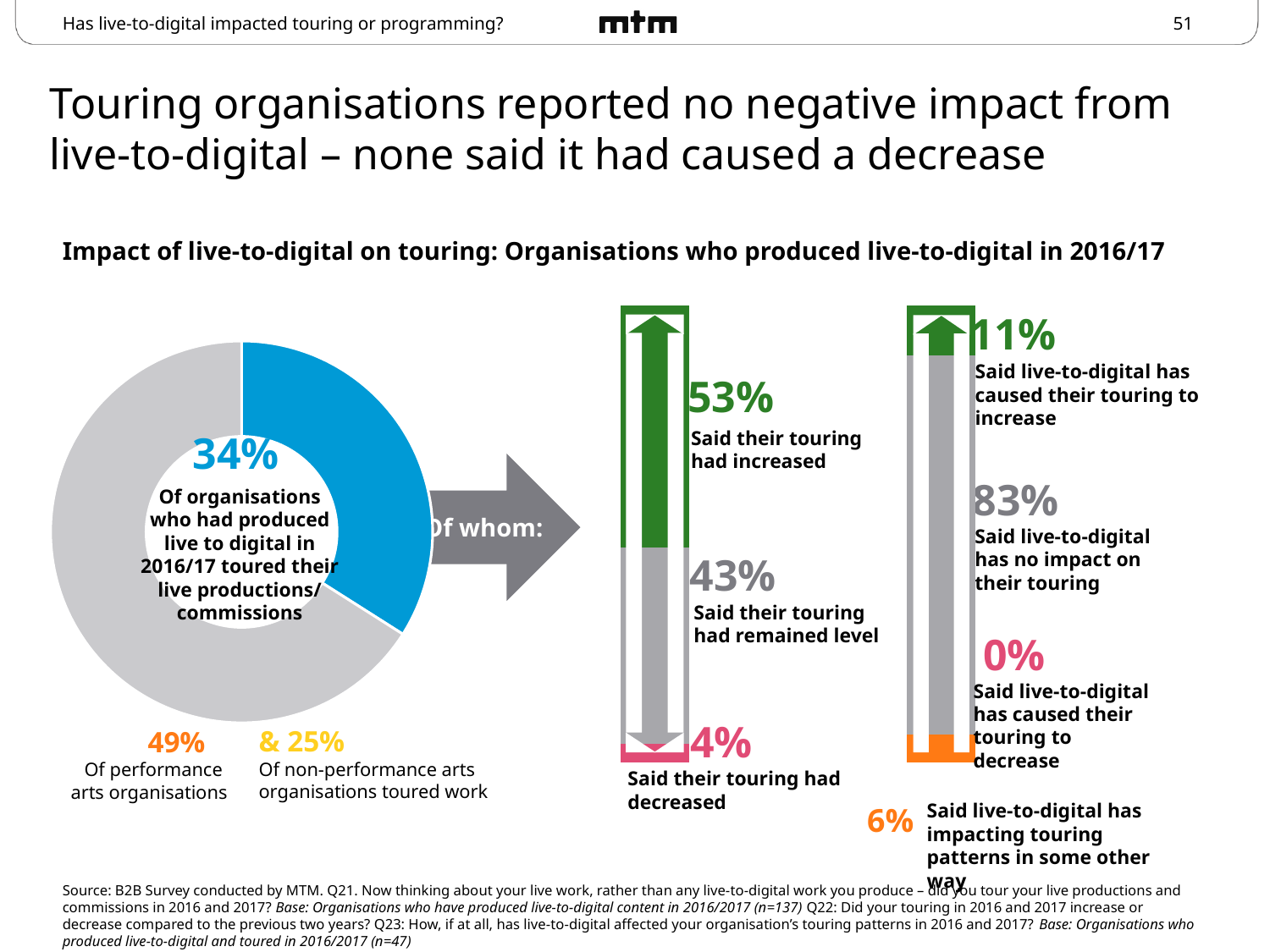
In the donut chart, what percentage of organisations who had produced live-to-digital in 2016/17 toured their live productions/commissions? 34% In the middle bar, what percentage said their touring had increased? 53% In the middle bar, what percentage said their touring had decreased? 4% What kind of chart is shown on the left of the slide? donut chart In the right-hand bar, what percentage said live-to-digital has caused their touring to decrease? 0% In the right-hand bar, which response has the lowest percentage? Said live-to-digital has caused their touring to decrease In the right-hand bar, is the share who said live-to-digital has no impact larger or smaller than the share who said it caused an increase? larger In the middle bar, what is the difference between the share who said touring had increased and the share who said it had remained level? 10% In the middle bar, which response has the highest percentage? Said their touring had increased In the right-hand bar, what percentage said live-to-digital has no impact on their touring? 83% In the right-hand bar, what percentage said live-to-digital has caused their touring to increase? 11% In the middle bar, what percentage said their touring had remained level? 43%